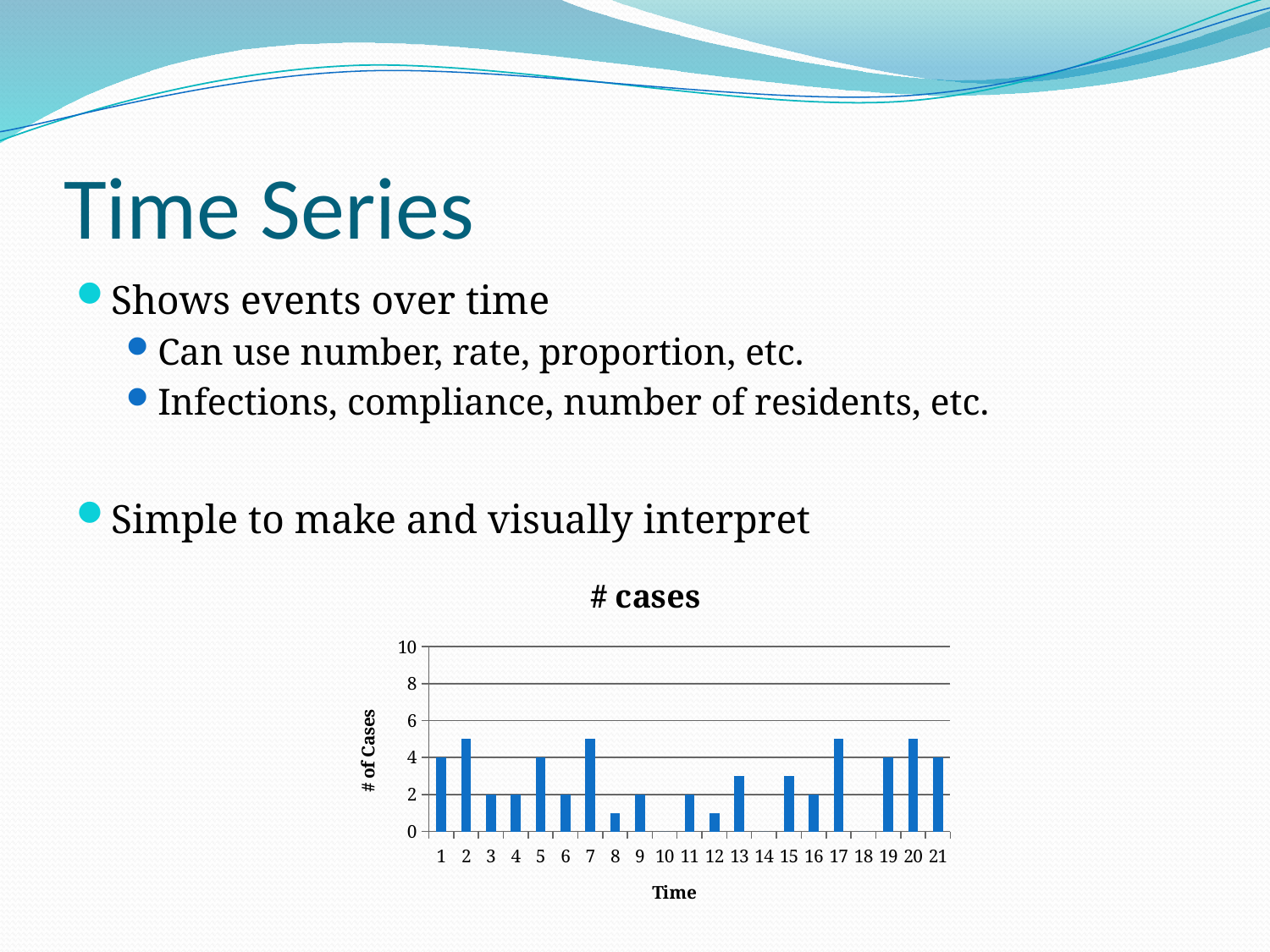
What is the label on the vertical axis of the chart? # of Cases How many time points are shown on the x axis of the chart? 21 What kind of chart is shown on the slide? bar chart What is the number of cases at time 1? 4 Is the value for time 13 greater or less than 2? greater Is the value for time 8 greater or less than 2? less Is the value for time 2 greater or less than 4? greater What is the title of the chart? # cases What is the number of cases at time 3? 2 Which has more cases, time 2 or time 3? time 2 Which has more cases, time 8 or time 1? time 1 What is the number of cases at time 19? 4